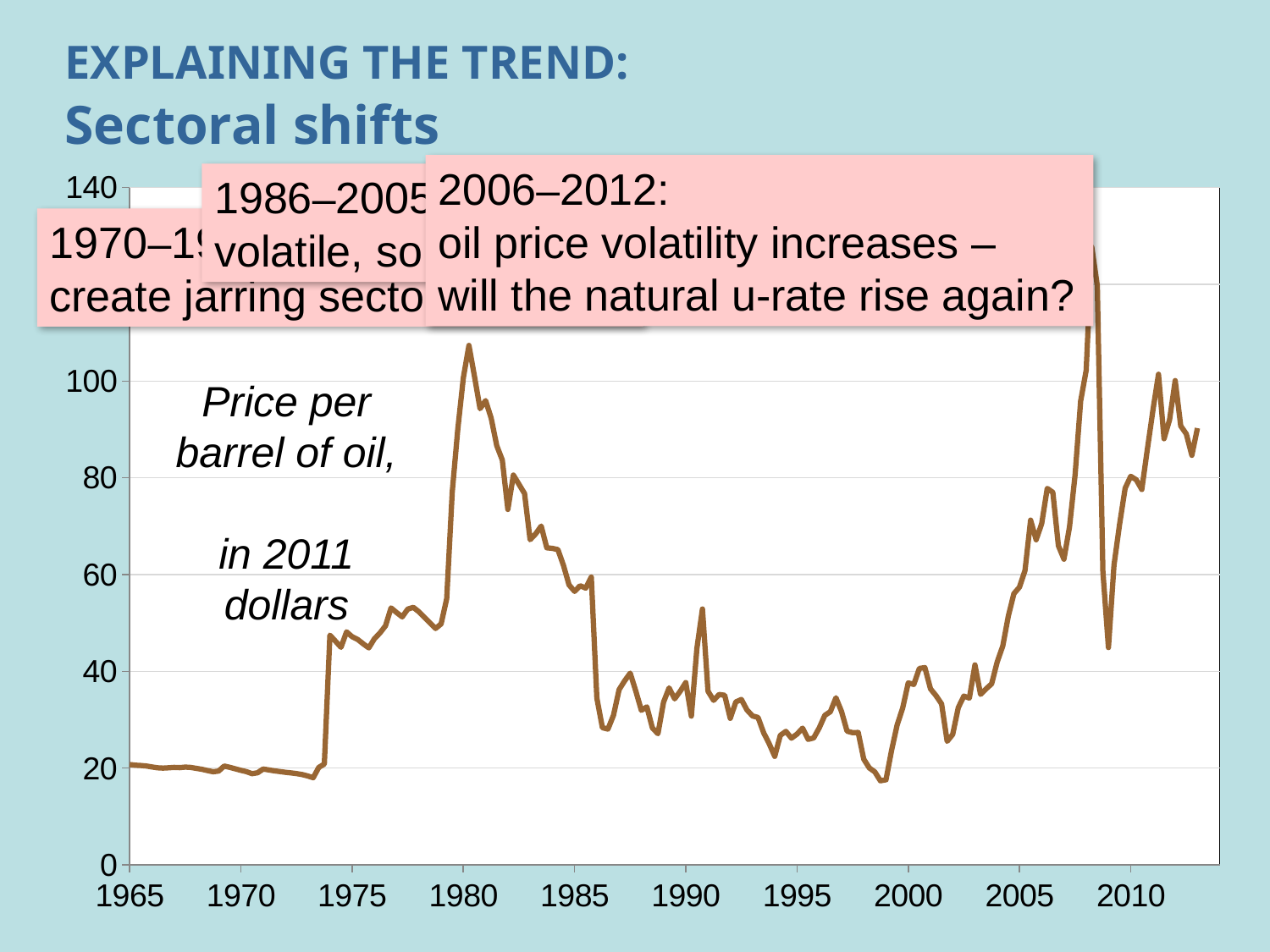
What kind of chart is shown on the slide? line chart Does the oil price rise or fall between 1980 and 1986? fall What does the line on the chart represent, according to the label inside the plot area? Price per barrel of oil, in 2011 dollars Does the oil price rise or fall between 1999 and 2008? rise What is the first year labeled on the x axis? 1965 Is the oil price at its 1980 peak greater or less than 100? greater Is the oil price in 1995 greater or less than 40? less Is the oil price in 1985 greater or less than 40? greater Around which year does the line reach its highest value? 2008 What is the highest value labeled on the y axis? 140